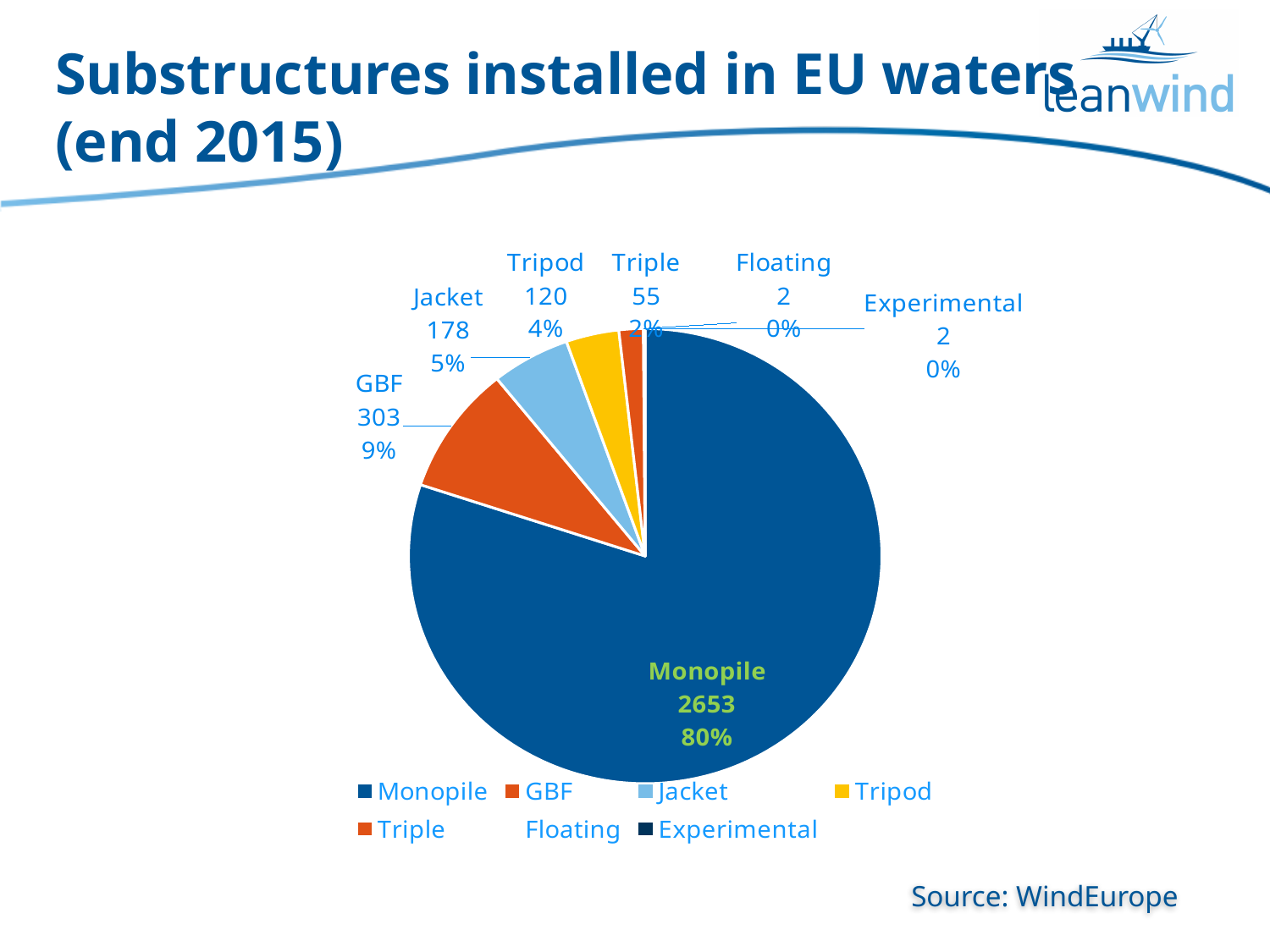
How many substructures of the Monopile type were installed in EU waters by end 2015? 2653 Which substructure type has the largest slice of the pie? Monopile What is the difference between the GBF value and the Jacket value? 125 Which is larger, the value for Tripod or the value for Triple? Tripod What share of the pie does Monopile represent? 80% What is the value shown for Tripod? 120 What is the title of the chart slide? Substructures installed in EU waters (end 2015) What type of chart is shown on the slide? pie chart What percentage of the pie is Jacket? 5% How many GBF substructures are shown on the chart? 303 What is the value shown for Floating? 2 How many substructure categories does the legend list? 7